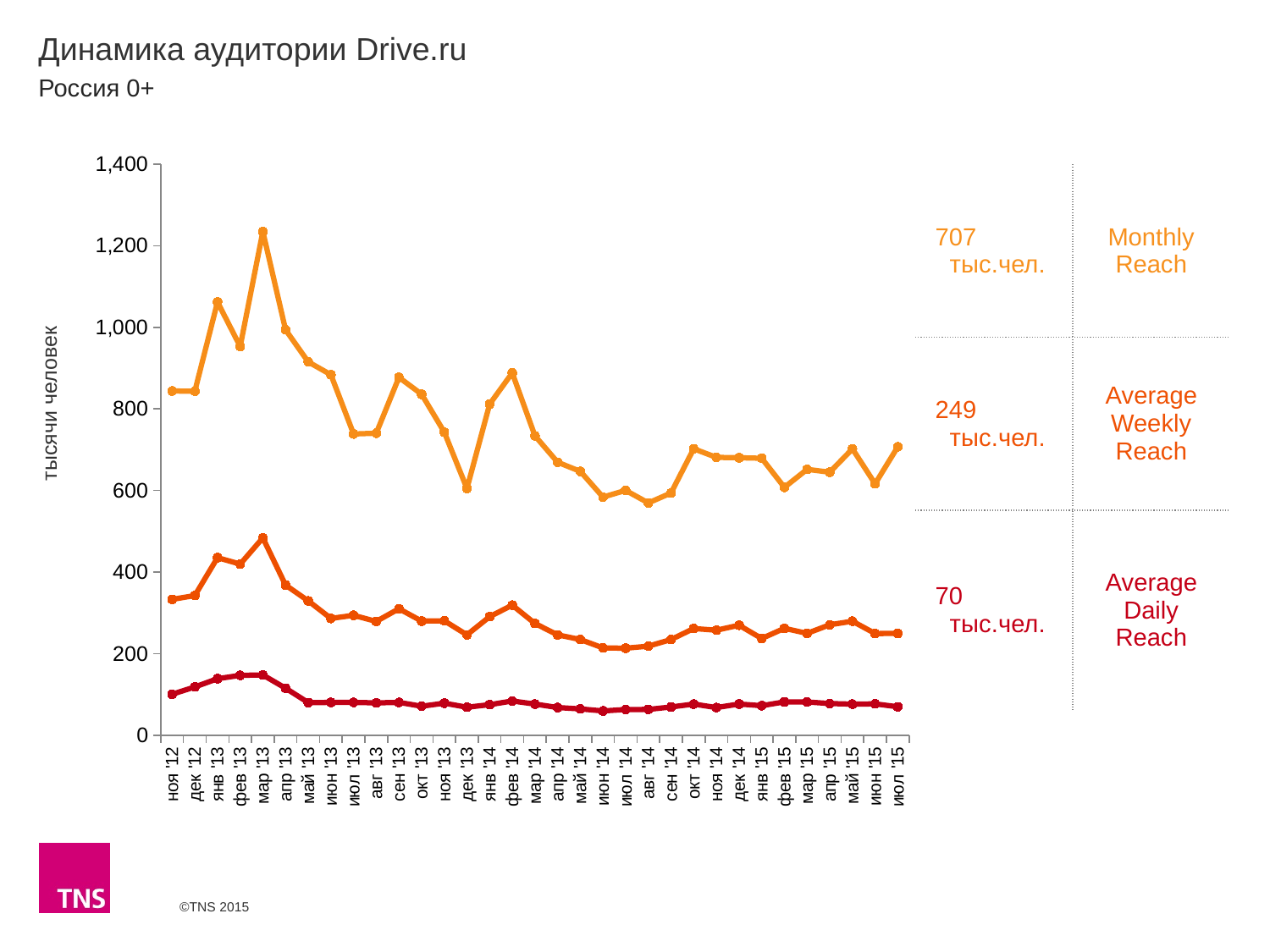
What is the label on the vertical axis of the chart? тысячи человек What is the Monthly Reach value for июл '15 shown on the slide? 707 тыс.чел. What is the Average Weekly Reach value for июл '15 shown on the slide? 249 тыс.чел. How many monthly data points are plotted along the x axis? 33 What kind of chart is shown on the slide? line chart Which is larger, the Monthly Reach in мар '13 or in июл '15? мар '13 Is the Average Weekly Reach value for мар '13 greater or less than 400? greater What is the difference between the Monthly Reach and the Average Weekly Reach values shown for июл '15? 458 тыс.чел. Is the Monthly Reach value for дек '13 greater or less than 800? less What is the Average Daily Reach value for июл '15 shown on the slide? 70 тыс.чел. Is the Monthly Reach value for мар '13 greater or less than 1,000? greater In which month does the Monthly Reach line reach its highest point? мар '13